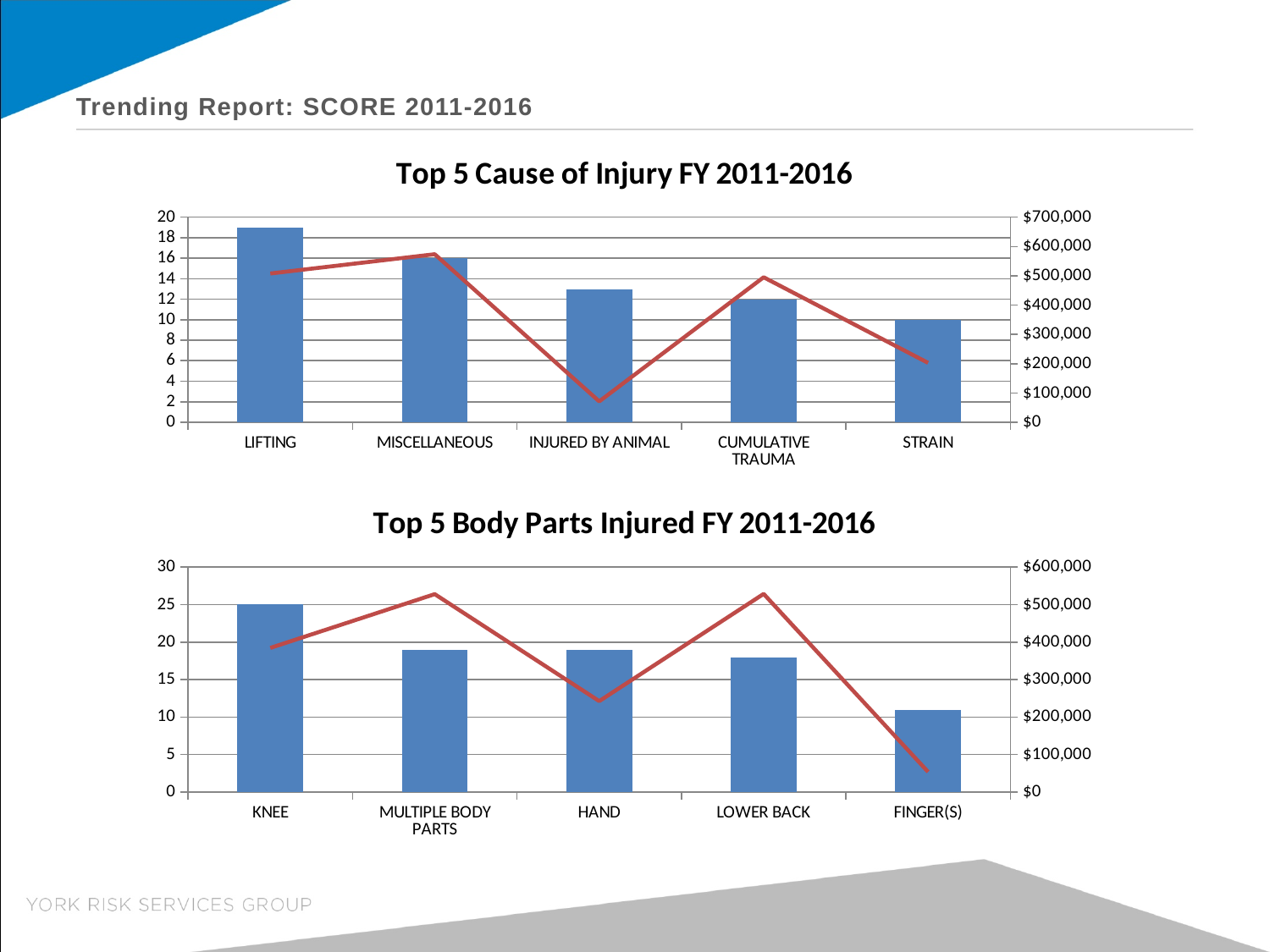
In the 'Top 5 Cause of Injury FY 2011-2016' chart, which category has the lowest point on the red line? INJURED BY ANIMAL In the 'Top 5 Cause of Injury FY 2011-2016' chart, which has the higher red line value, LIFTING or MISCELLANEOUS? MISCELLANEOUS In the 'Top 5 Cause of Injury FY 2011-2016' chart, what is the bar value for MISCELLANEOUS? 16 In the 'Top 5 Body Parts Injured FY 2011-2016' chart, which category has the shortest bar? FINGER(S) In the 'Top 5 Body Parts Injured FY 2011-2016' chart, is the bar value for HAND greater or less than 15? greater In the 'Top 5 Body Parts Injured FY 2011-2016' chart, what is the bar value for KNEE? 25 In the 'Top 5 Cause of Injury FY 2011-2016' chart, which category has the tallest bar? LIFTING In the 'Top 5 Cause of Injury FY 2011-2016' chart, what is the difference between the bar values for MISCELLANEOUS and STRAIN? 6 How many categories are shown in the 'Top 5 Body Parts Injured FY 2011-2016' chart? 5 In the 'Top 5 Cause of Injury FY 2011-2016' chart, what is the bar value for STRAIN? 10 In the 'Top 5 Cause of Injury FY 2011-2016' chart, is the red line value for INJURED BY ANIMAL greater or less than $200,000? less What kind of chart is the 'Top 5 Cause of Injury FY 2011-2016' chart? Bar chart with a line overlay